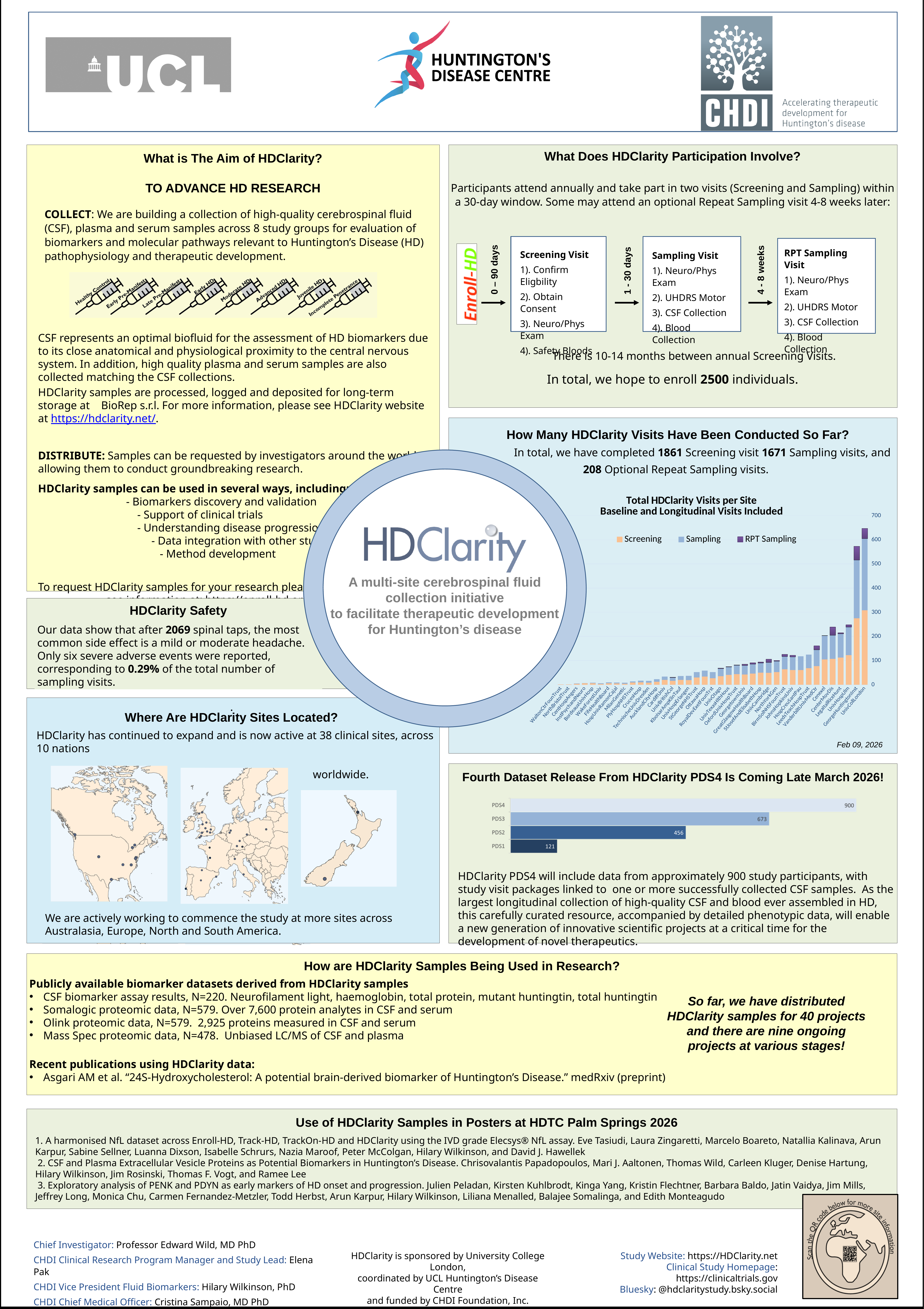
In the 'Total HDClarity Visits per Site' chart, is the total for UnivCollLondon greater or less than 600? greater In the 'Total HDClarity Visits per Site' chart, how many series does the legend list? 3 In the 'Total HDClarity Visits per Site' chart, do the bar totals rise or fall from left to right along the x axis? rise In the PDS dataset release chart in the 'Fourth Dataset Release' panel, what is the difference between the PDS3 and PDS2 values? 217 In the 'Total HDClarity Visits per Site' chart, which site has the highest total number of visits? UnivCollLondon What date is printed beneath the 'Total HDClarity Visits per Site' chart? Feb 09, 2026 What kind of chart is 'Total HDClarity Visits per Site'? Stacked bar chart In the 'Total HDClarity Visits per Site' chart, what are the three legend entries? Screening, Sampling, RPT Sampling In the PDS dataset release chart in the 'Fourth Dataset Release' panel, which has the larger value, PDS2 or PDS3? PDS3 In the PDS dataset release chart in the 'Fourth Dataset Release' panel, what is the value for PDS1? 121 In the PDS dataset release chart in the 'Fourth Dataset Release' panel, what is the value for PDS4? 900 In the PDS dataset release chart in the 'Fourth Dataset Release' panel, how many categories are shown? 4